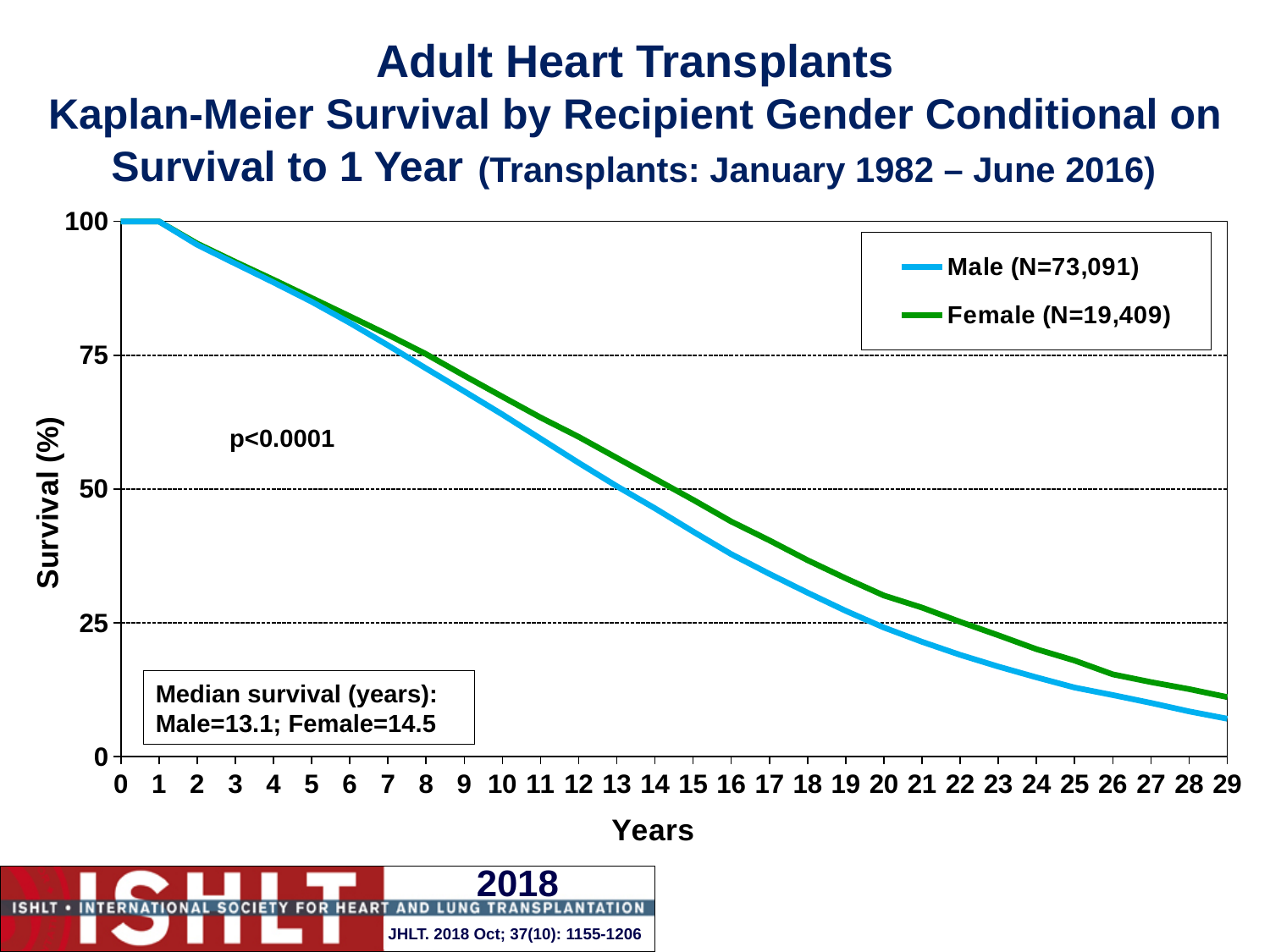
Is the survival value for Female at 20 years greater or less than 25? greater What is the N for the Male series shown in the legend? 73,091 What is the median survival in years for female recipients? 14.5 Is the survival value for Male at 10 years greater or less than 50? greater Do the survival curves rise or fall as years increase? fall Which group has the longer median survival, male or female? Female What is the median survival in years for male recipients? 13.1 Is the survival value for Male at 29 years greater or less than 25? less What p-value is shown on the chart? p<0.0001 What kind of chart is shown on the slide? line chart How many series does the legend list? 2 What is the difference in median survival (years) between female and male recipients? 1.4